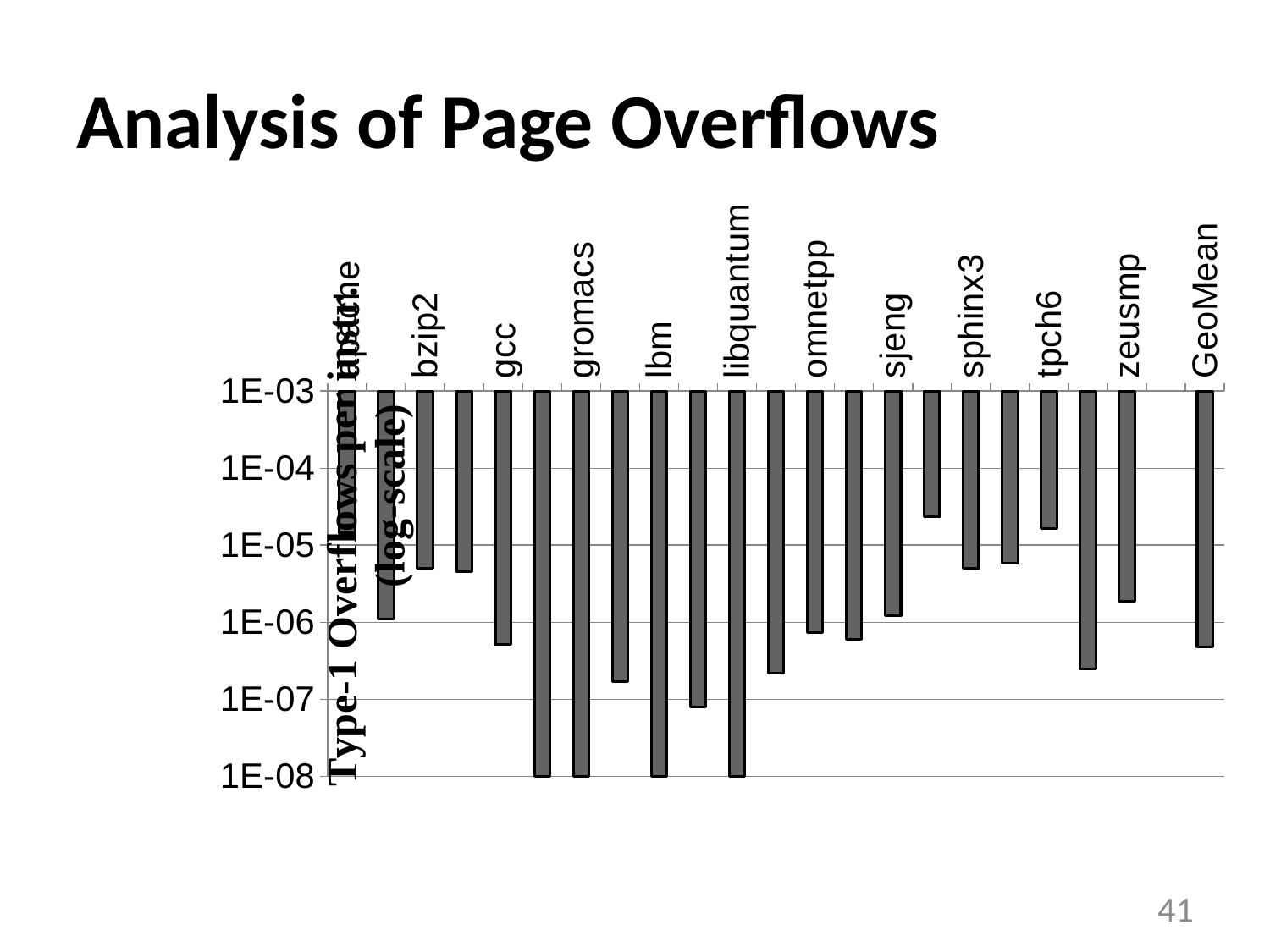
Is the value for libquantum greater or less than 1E-06? less Which has the larger value, tpch6 or gcc? tpch6 Is the value for lbm greater or less than 1E-07? less Which has the larger value, bzip2 or gromacs? bzip2 Is the value for GeoMean greater or less than 1E-06? less What is the label of the vertical axis of the chart? Type-1 Overflows per instr. (log scale) What is the lowest tick value shown on the vertical axis? 1E-08 What kind of chart is shown on the slide? bar chart